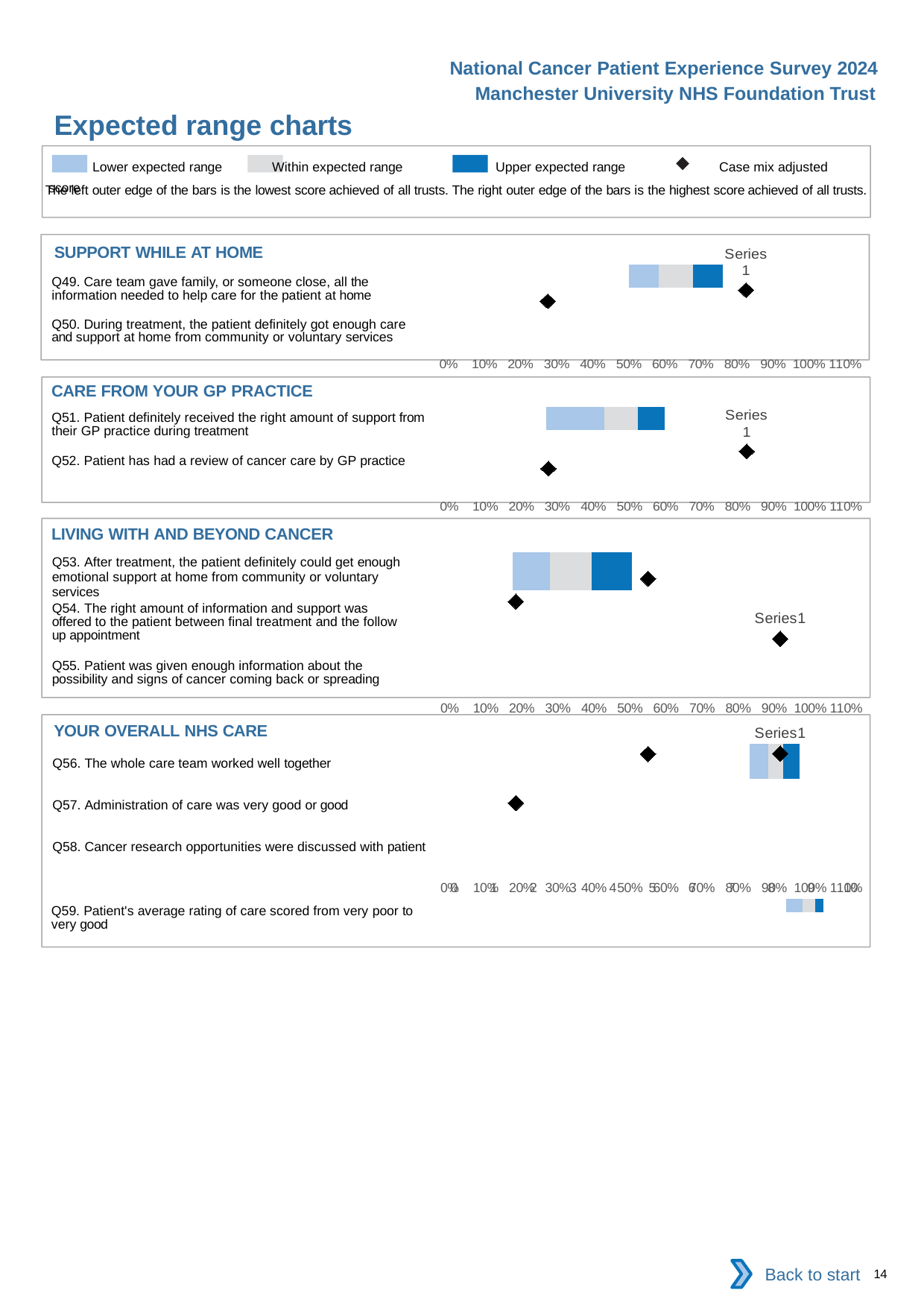
In the CARE FROM YOUR GP PRACTICE chart, is the rightmost diamond marker greater or less than 70%? greater How many entries does the legend at the top of the slide list? 4 In the legend, which colour represents the upper expected range? dark blue What is the highest value shown on the x axis of the CARE FROM YOUR GP PRACTICE chart? 110% What kind of chart is used in the SUPPORT WHILE AT HOME section? bar chart What is the title of the slide's charts? Expected range charts In the SUPPORT WHILE AT HOME chart, is the leftmost diamond marker greater or less than 40%? less How many questions are listed in the LIVING WITH AND BEYOND CANCER chart? 3 In the LIVING WITH AND BEYOND CANCER chart, is the leftmost diamond marker greater or less than 30%? less How many questions are listed in the YOUR OVERALL NHS CARE chart? 4